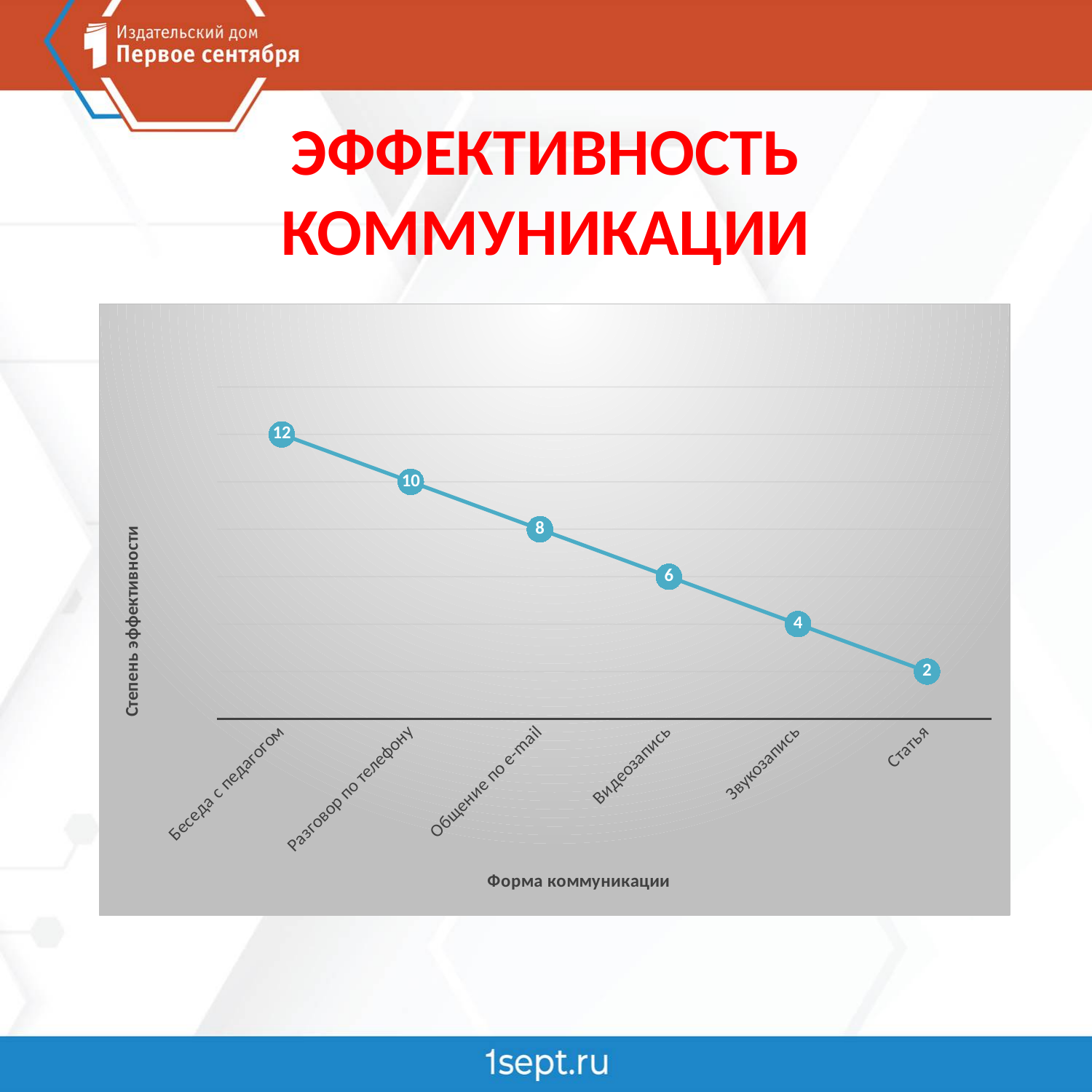
What kind of chart is shown on the slide? Line chart What is the value for Статья? 2 Which form of communication has the highest value? Беседа с педагогом What is the value for Общение по e-mail? 8 What is the value for Звукозапись? 4 How many categories are plotted on the x axis? 6 Which form of communication has the lowest value? Статья What is the value for Беседа с педагогом? 12 Do the values rise or fall from left to right along the x axis? Fall What is the label of the x axis? Форма коммуникации Which is larger, the value for Видеозапись or the value for Звукозапись? Видеозапись What is the difference between the values for Разговор по телефону and Видеозапись? 4